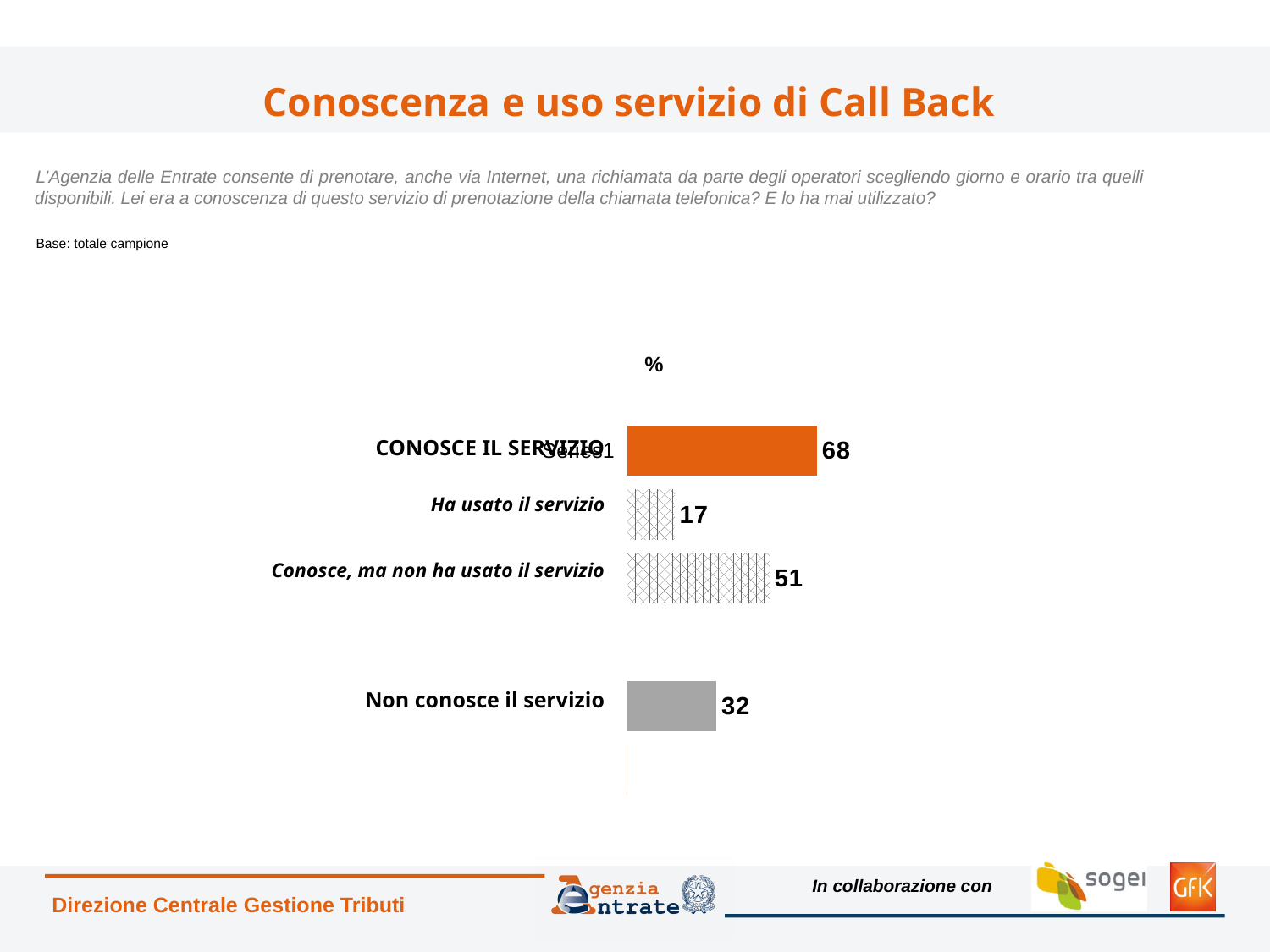
What is the value for "Ha usato il servizio"? 17 What is the value for "Conosce, ma non ha usato il servizio"? 51 What is the value for "CONOSCE IL SERVIZIO"? 68 Which category has the highest value? CONOSCE IL SERVIZIO How many bars are shown in the chart? 4 What is the difference between "CONOSCE IL SERVIZIO" and "Non conosce il servizio"? 36 What is the value for "Non conosce il servizio"? 32 Which category has the lowest value? Ha usato il servizio What unit label is shown above the bars? % Which is larger, "Non conosce il servizio" or "Ha usato il servizio"? Non conosce il servizio What kind of chart is shown on the slide? Bar chart What is the difference between "Conosce, ma non ha usato il servizio" and "Ha usato il servizio"? 34